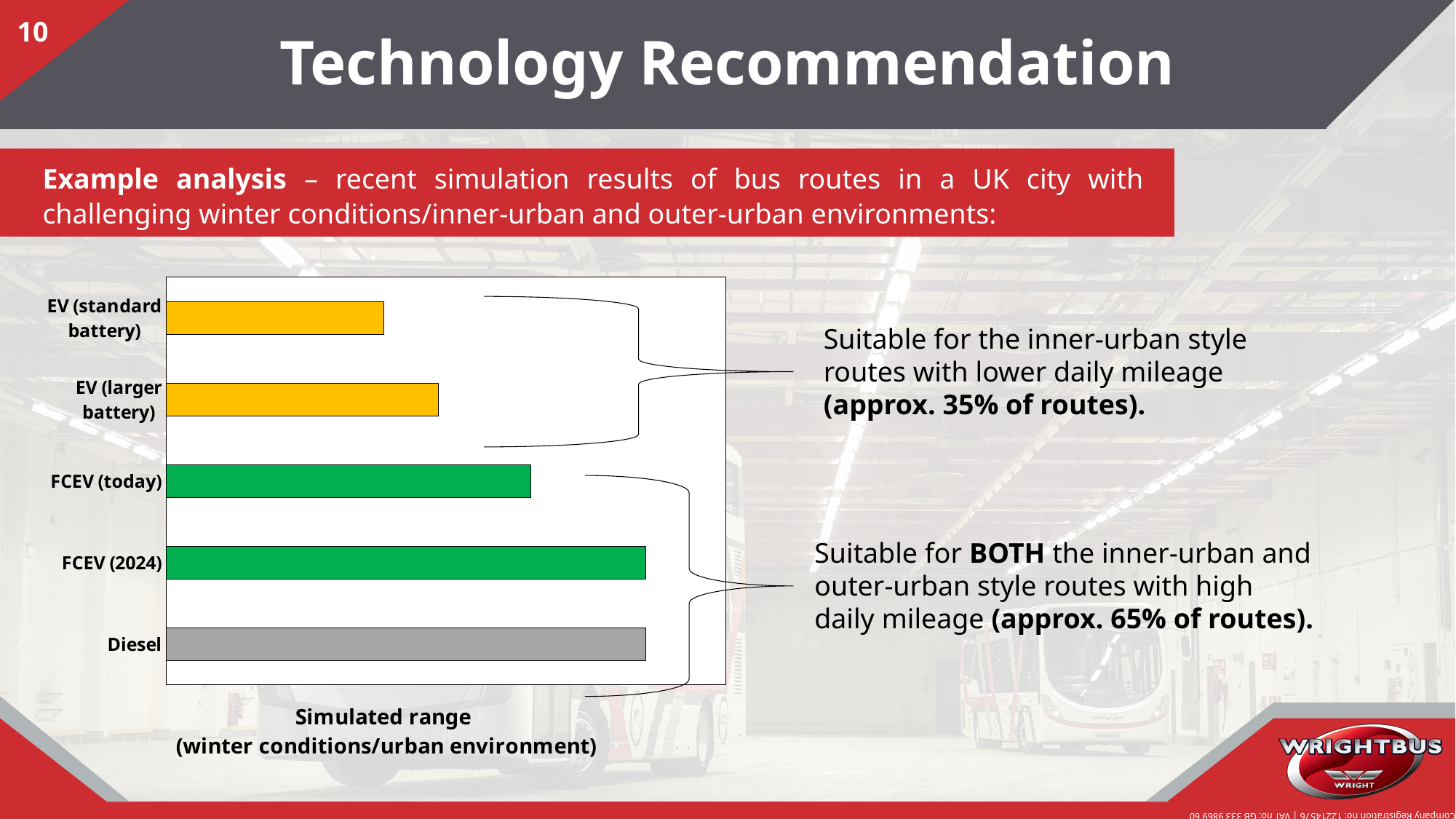
Which category has the shortest bar (lowest simulated range)? EV (standard battery) Which has the longer bar, Diesel or FCEV (today)? Diesel What is the label shown beneath the chart's horizontal axis? Simulated range (winter conditions/urban environment) Which has the longer bar, FCEV (today) or EV (larger battery)? FCEV (today) Which has the longer bar, EV (standard battery) or EV (larger battery)? EV (larger battery) What colour are the FCEV bars in the chart? Green How many categories (bars) does the chart show? 5 What kind of chart is shown on the slide? Bar chart